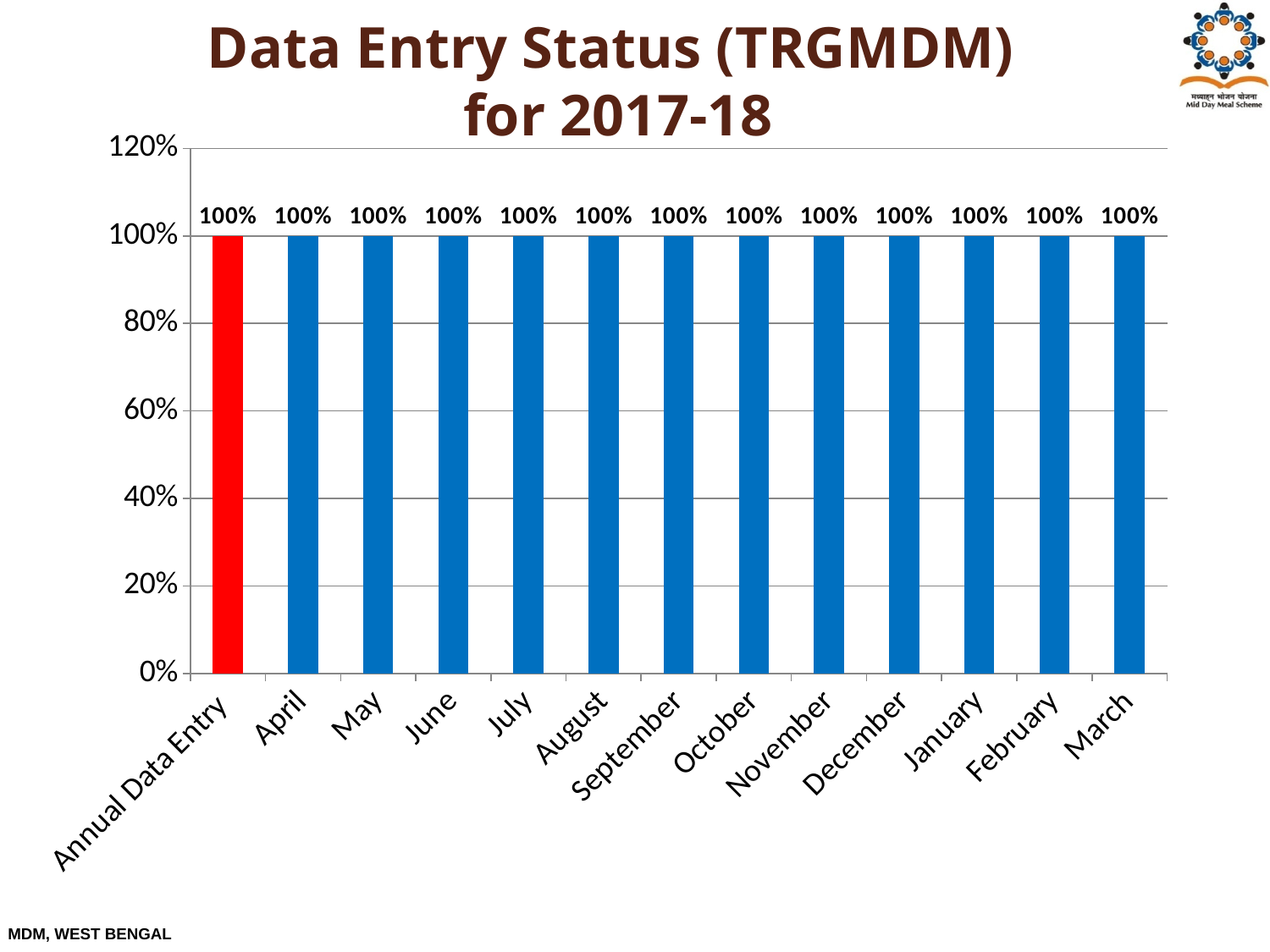
What is the highest value shown on the y axis? 120% What is the value for December? 100% How many categories are shown on the x axis? 13 What is the value for April? 100% What is the value for Annual Data Entry? 100% What is the title of the chart? Data Entry Status (TRGMDM) for 2017-18 Is the value for July greater or less than 80%? greater Do the values rise, fall, or stay flat from April to March? stay flat What is the difference between the values for September and January? 0% Which category's bar is coloured red? Annual Data Entry What kind of chart is shown on the slide? bar chart What is the value for March? 100%